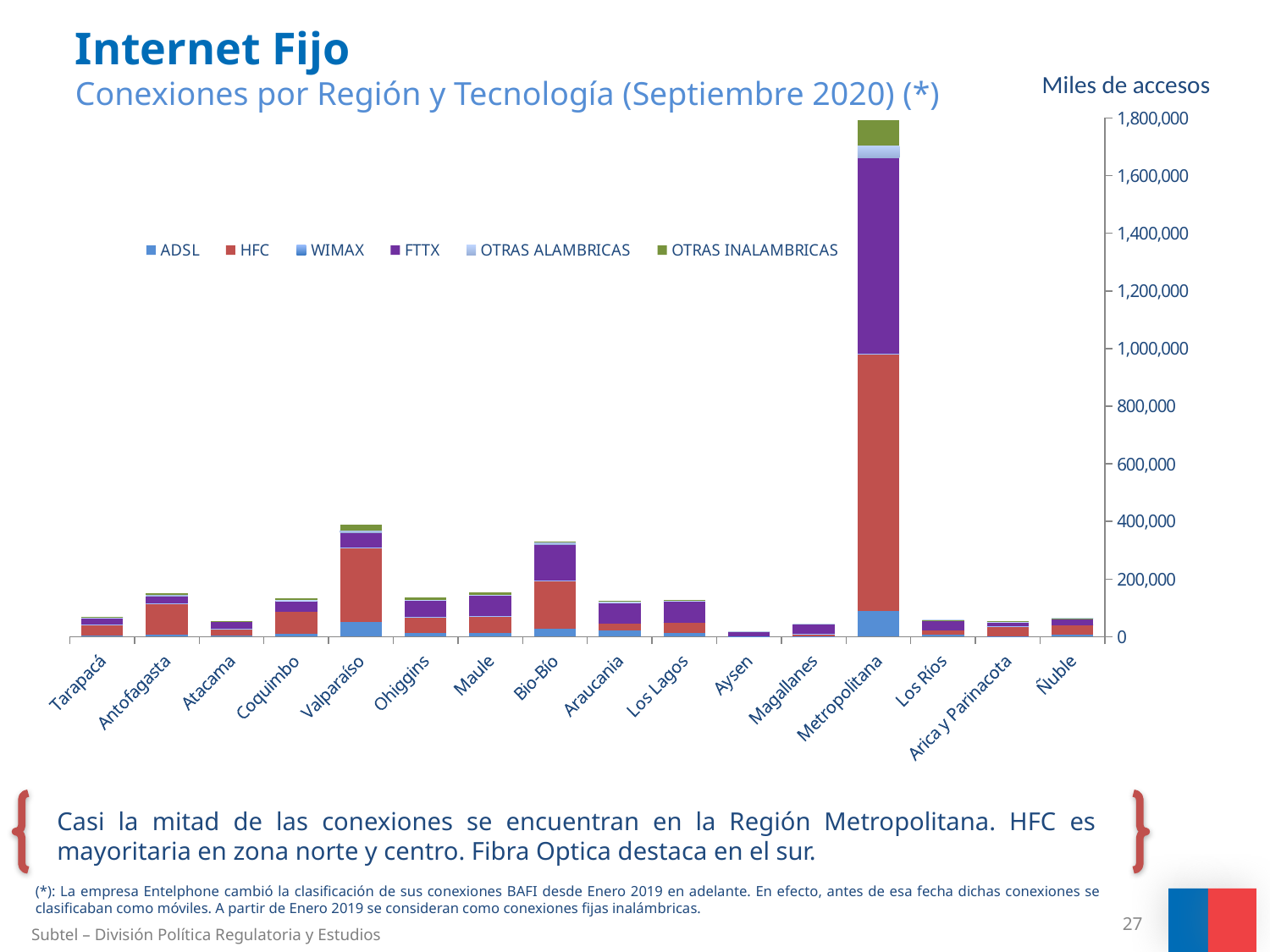
How many series does the chart's legend list? 6 Which region has the lowest total number of connections? Aysen Is the total value for Valparaíso greater or less than 200,000? greater Is the total value for Tarapacá greater or less than 200,000? less Which series is shown in red in the chart's legend? HFC Is the total value for Metropolitana greater or less than 1,600,000? greater Which region has the highest total number of connections? Metropolitana What kind of chart is shown on the slide? Stacked bar chart Which region has a larger total, Antofagasta or Atacama? Antofagasta Which region has a larger total, Valparaíso or Bio-Bío? Valparaíso How many regions are shown along the x axis of the chart? 16 What unit label is shown above the chart's vertical axis? Miles de accesos